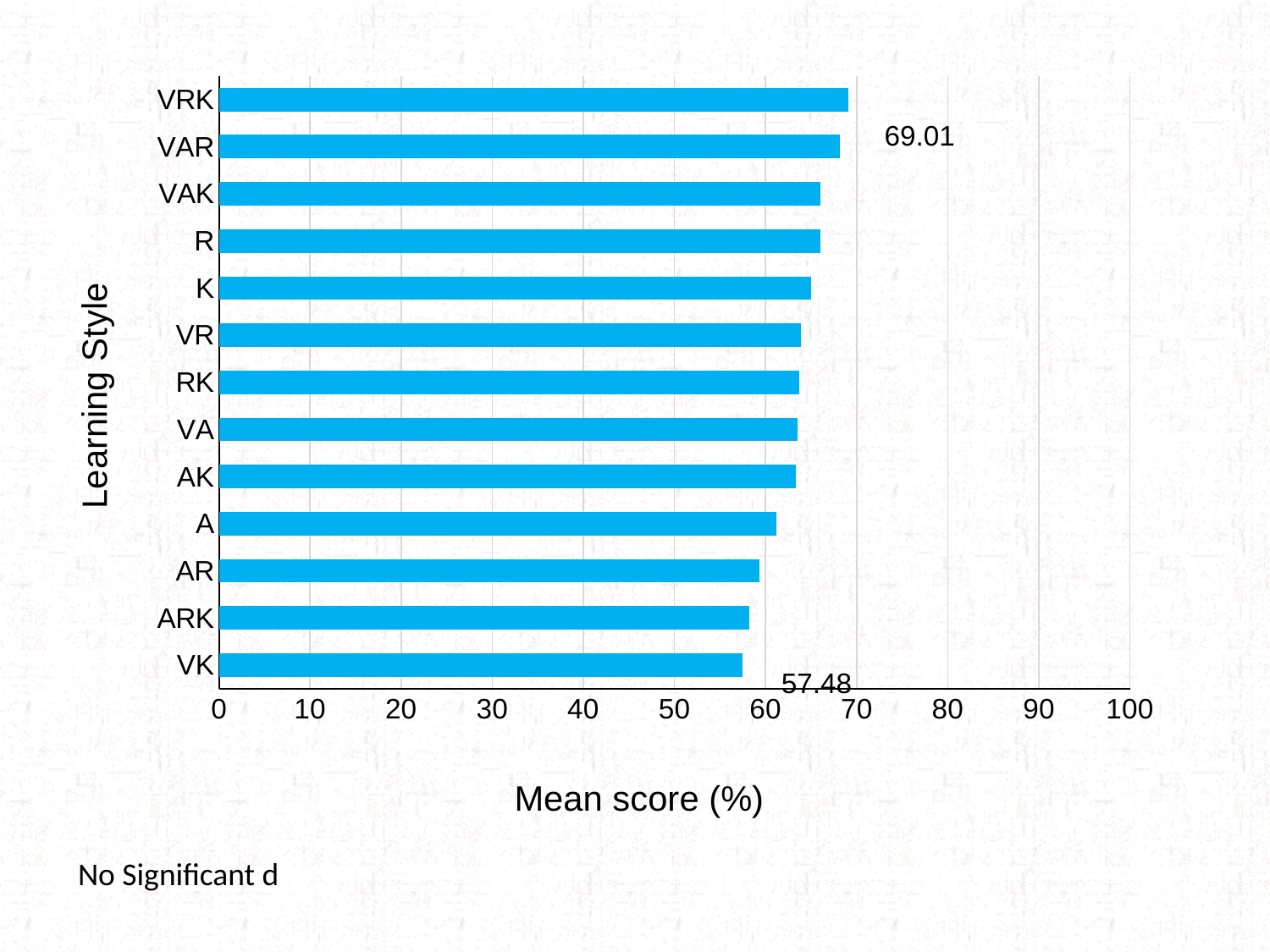
What kind of chart is shown on the slide? bar chart What is the mean score labelled for VK? 57.48 Is the value for VK greater or less than 60? less Which learning style has the lowest mean score? VK What is the title of the horizontal axis? Mean score (%) Which learning style has the highest mean score? VRK What is the difference between the labelled mean scores of VRK and VK? 11.53 Is the value for K greater or less than 60? greater What is the mean score labelled for VRK? 69.01 Which has a higher mean score, VRK or VK? VRK How many learning styles are plotted on the chart? 13 What is the title of the vertical axis? Learning Style